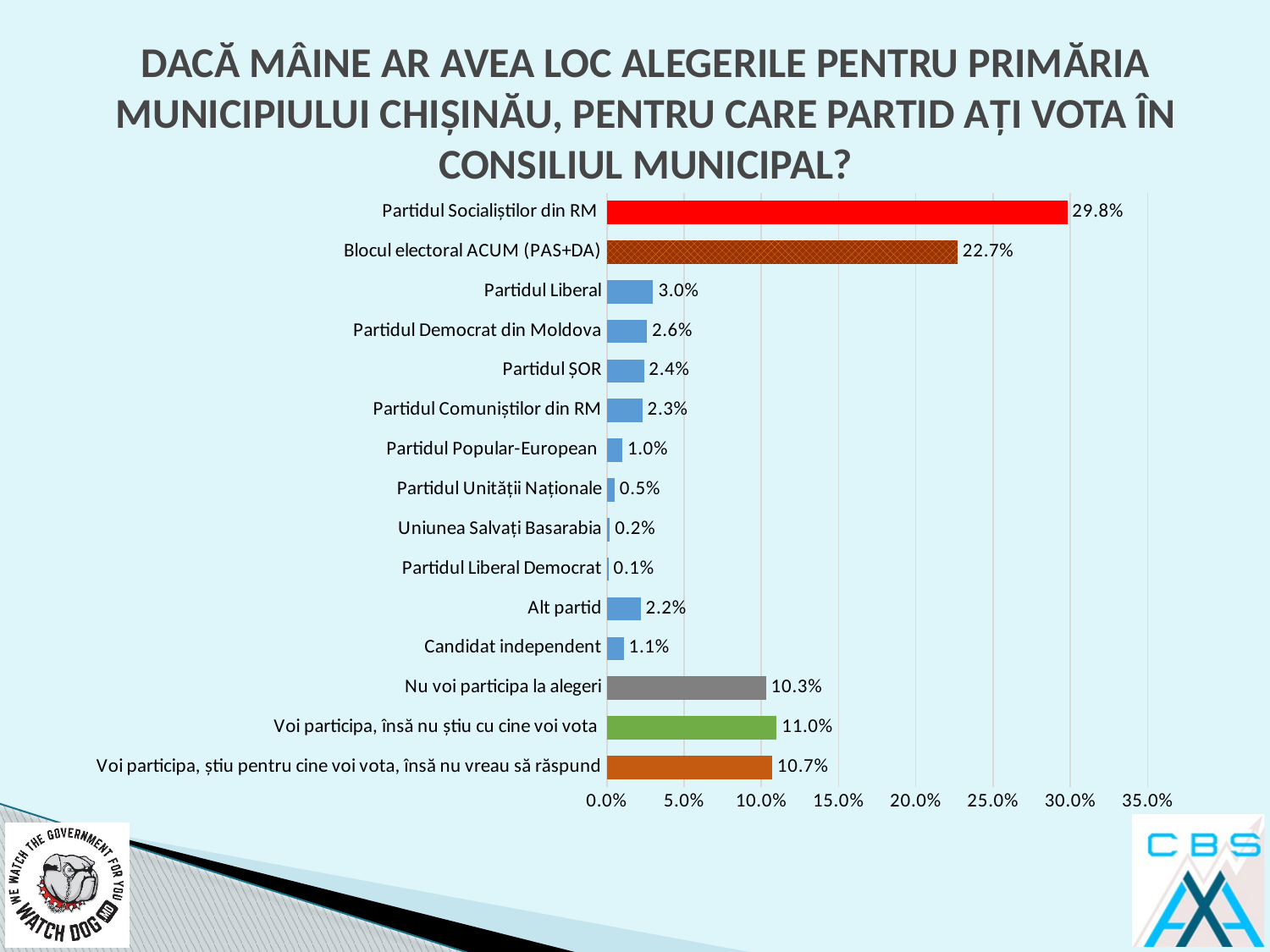
Which category has the highest value? Partidul Socialiștilor din RM What kind of chart is shown on the slide? bar chart What percentage is shown for Partidul Socialiștilor din RM? 29.8% What is the highest value shown on the x axis? 35.0% What is the difference between Partidul Socialiștilor din RM and Blocul electoral ACUM (PAS+DA)? 7.1% What percentage is shown for Nu voi participa la alegeri? 10.3% What value is shown for Blocul electoral ACUM (PAS+DA)? 22.7% What value is shown for Partidul ȘOR? 2.4% Which category has the lowest value? Partidul Liberal Democrat Is the value for Blocul electoral ACUM (PAS+DA) greater or less than 20.0%? greater Which is larger: Voi participa, însă nu știu cu cine voi vota or Nu voi participa la alegeri? Voi participa, însă nu știu cu cine voi vota How many categories are shown in the chart? 15